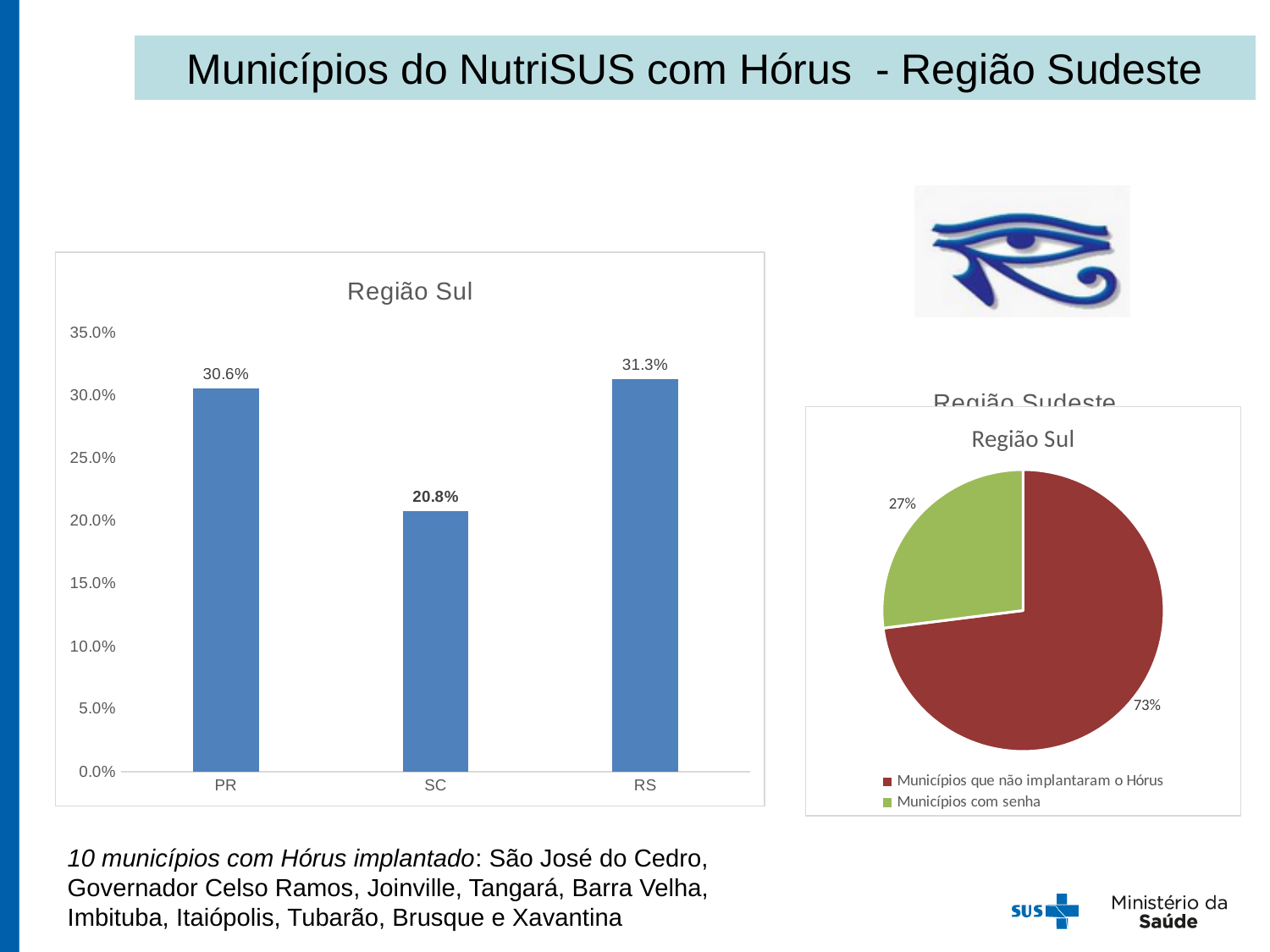
In the bar chart on the left, what is the value for PR? 30.6% What kind of chart is the chart on the left of the slide? bar chart In the pie chart on the right, what share is labelled for 'Municípios com senha'? 27% In the bar chart on the left, is the value for SC greater or less than 25.0%? less In the bar chart on the left, what is the value for RS? 31.3% How many categories are shown on the x axis of the bar chart on the left? 3 In the pie chart on the right, what share is labelled for 'Municípios que não implantaram o Hórus'? 73% In the bar chart on the left, which category has the lowest value? SC In the bar chart on the left, which category has the highest value? RS In the bar chart on the left, what is the difference between the values for RS and SC? 10.5% How many entries does the legend of the pie chart on the right list? 2 In the bar chart on the left, what is the value for SC? 20.8%